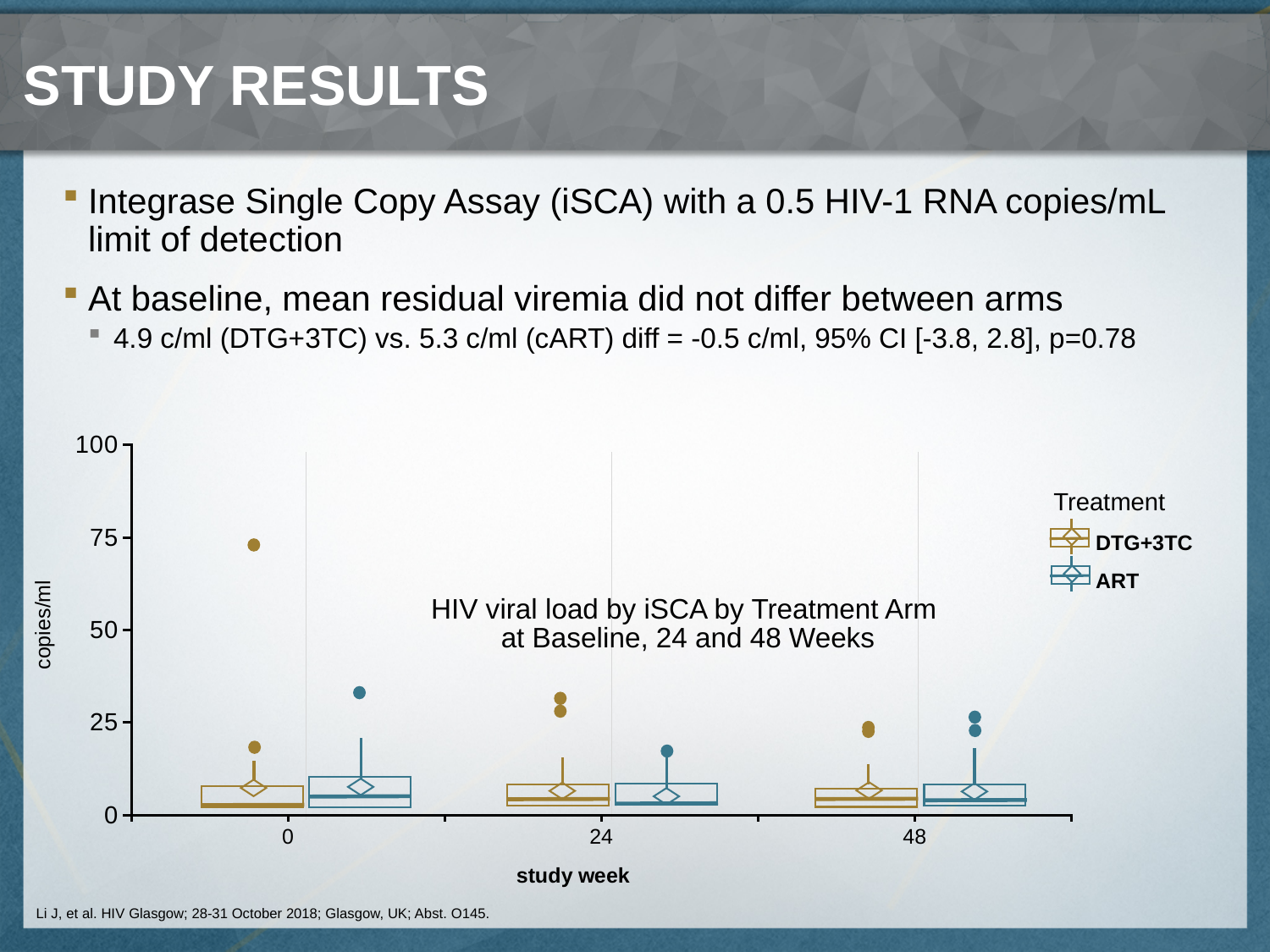
Is the median of the DTG+3TC box at study week 48 greater or less than 25 copies/ml? less Is the highest outlier point for ART at study week 0 greater or less than 25 copies/ml? greater How many treatment arms does the chart legend list? 2 What is the highest value shown on the y axis of the chart? 100 What is the label of the y axis of the chart? copies/ml At study week 0, which treatment arm has the highest single outlier point? DTG+3TC Is the highest outlier point for DTG+3TC at study week 0 greater or less than 50 copies/ml? greater What are the study weeks shown on the x axis of the chart? 0, 24 and 48 How many study weeks are shown along the x axis of the chart? 3 What is the title of the chart? HIV viral load by iSCA by Treatment Arm at Baseline, 24 and 48 Weeks What kind of chart is shown on the slide? Box plot